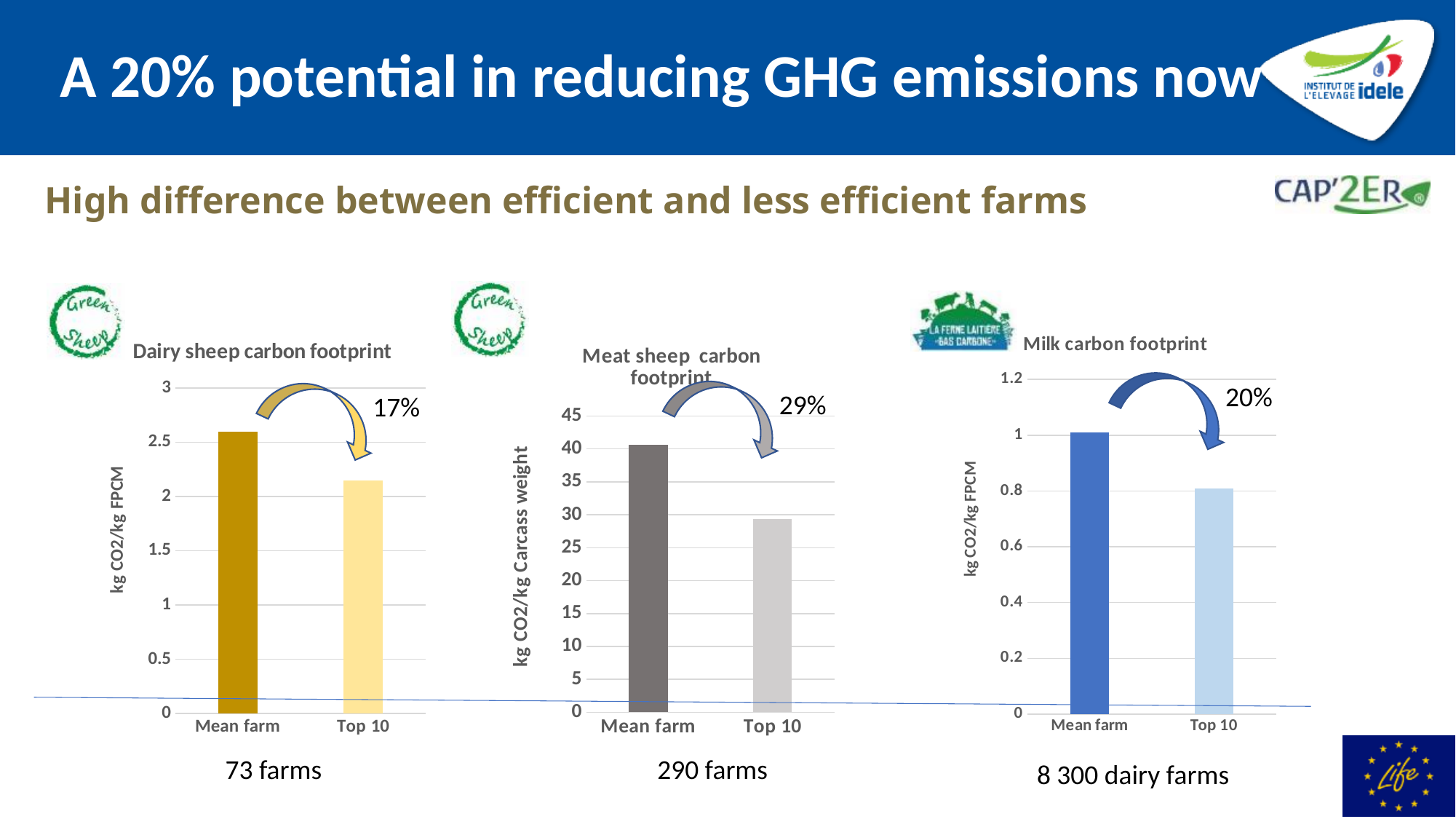
In the Dairy sheep carbon footprint chart, is the value for Top 10 greater or less than 2.5? less In the Milk carbon footprint chart, is the value for Top 10 greater or less than 1? less In the Milk carbon footprint chart, which category has the lowest value? Top 10 In the Meat sheep carbon footprint chart, is the value for Mean farm larger or smaller than the value for Top 10? larger In the Milk carbon footprint chart, is the value for Mean farm greater or less than 0.8? greater In the Dairy sheep carbon footprint chart, which category has the highest value? Mean farm What kind of chart is the Dairy sheep carbon footprint chart? bar chart What is the y-axis label of the Meat sheep carbon footprint chart? kg CO2/kg Carcass weight How many categories are shown on the x axis of the Meat sheep carbon footprint chart? 2